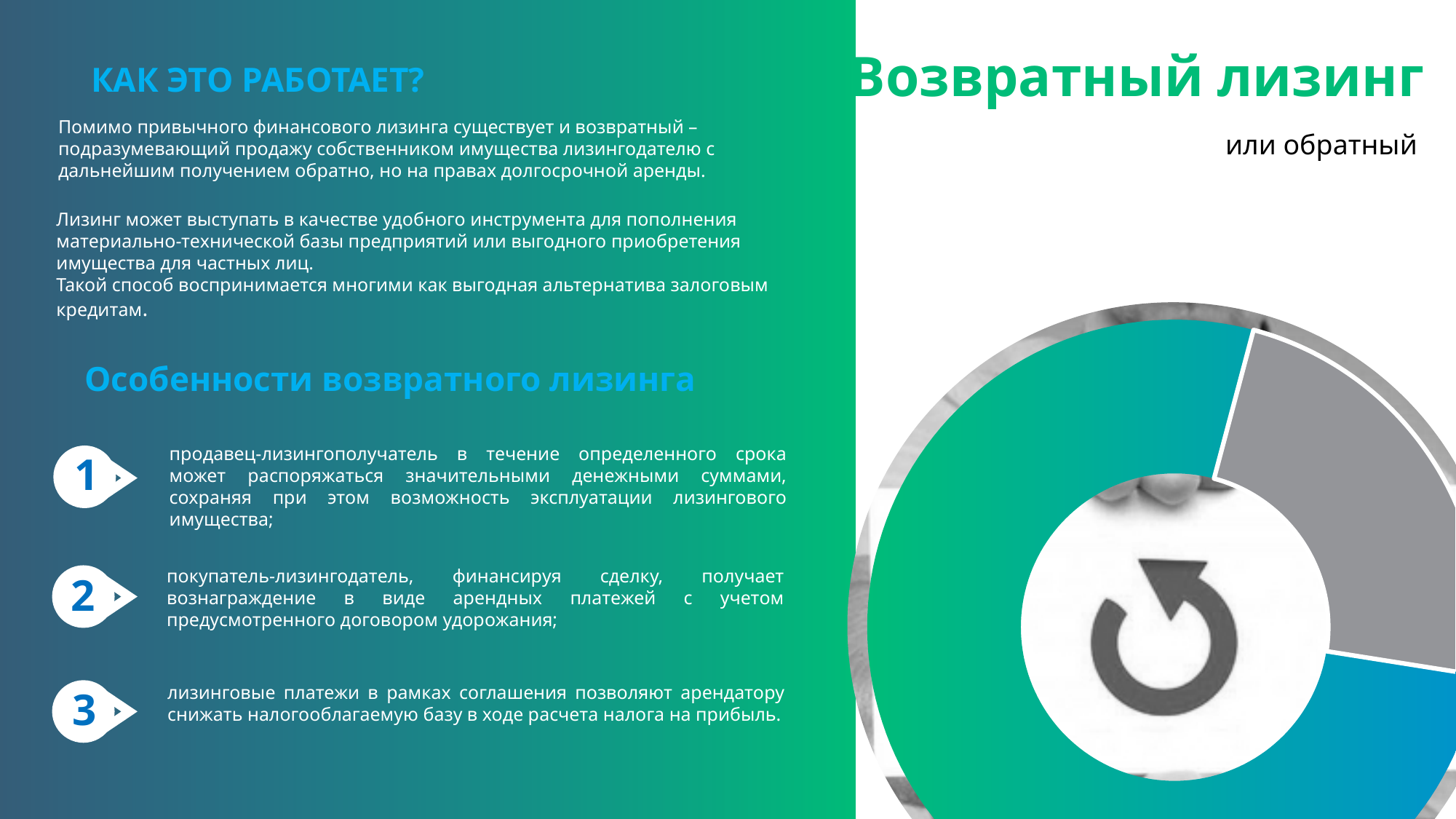
Which colour segment of the doughnut chart is the smallest? grey How many segments does the doughnut chart on the right have? 2 What icon is shown in the centre of the doughnut chart? a circular arrow Which colour segment of the doughnut chart is the largest? green What kind of chart is shown on the right side of the slide? doughnut chart